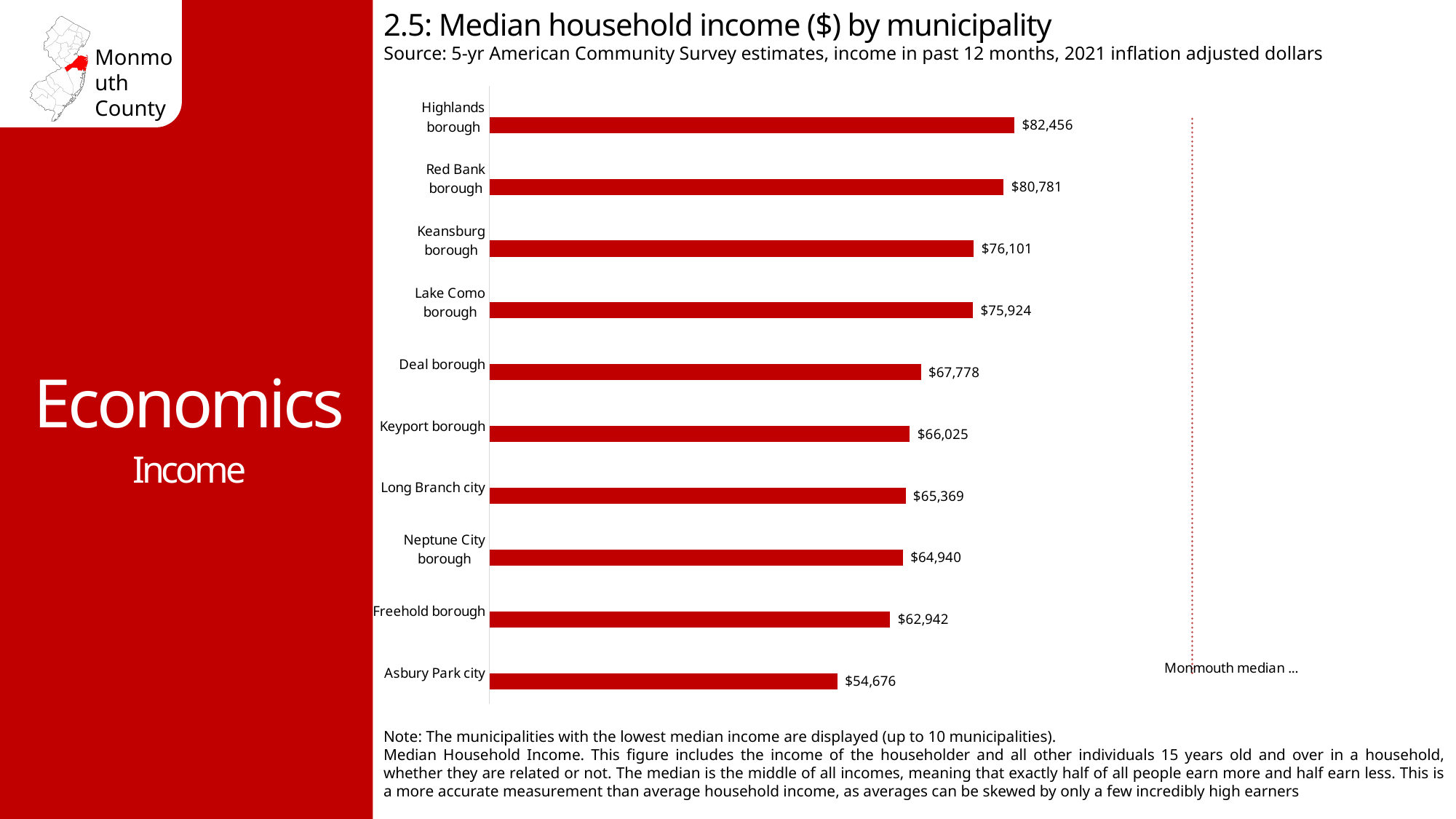
How many municipalities are shown on the chart? 10 What is the median household income for Asbury Park city? $54,676 Which municipality has the lowest median household income shown on the chart? Asbury Park city What is the median household income for Keyport borough? $66,025 What is the difference in median household income between Highlands borough and Red Bank borough? $1,675 What is the median household income for Highlands borough? $82,456 Which has a higher median household income, Deal borough or Long Branch city? Deal borough Which has a higher median household income, Keansburg borough or Neptune City borough? Keansburg borough Which municipality has the highest median household income shown on the chart? Highlands borough What is the difference in median household income between Freehold borough and Asbury Park city? $8,266 What kind of chart is shown on the slide? Bar chart What is the title of the chart? 2.5: Median household income ($) by municipality